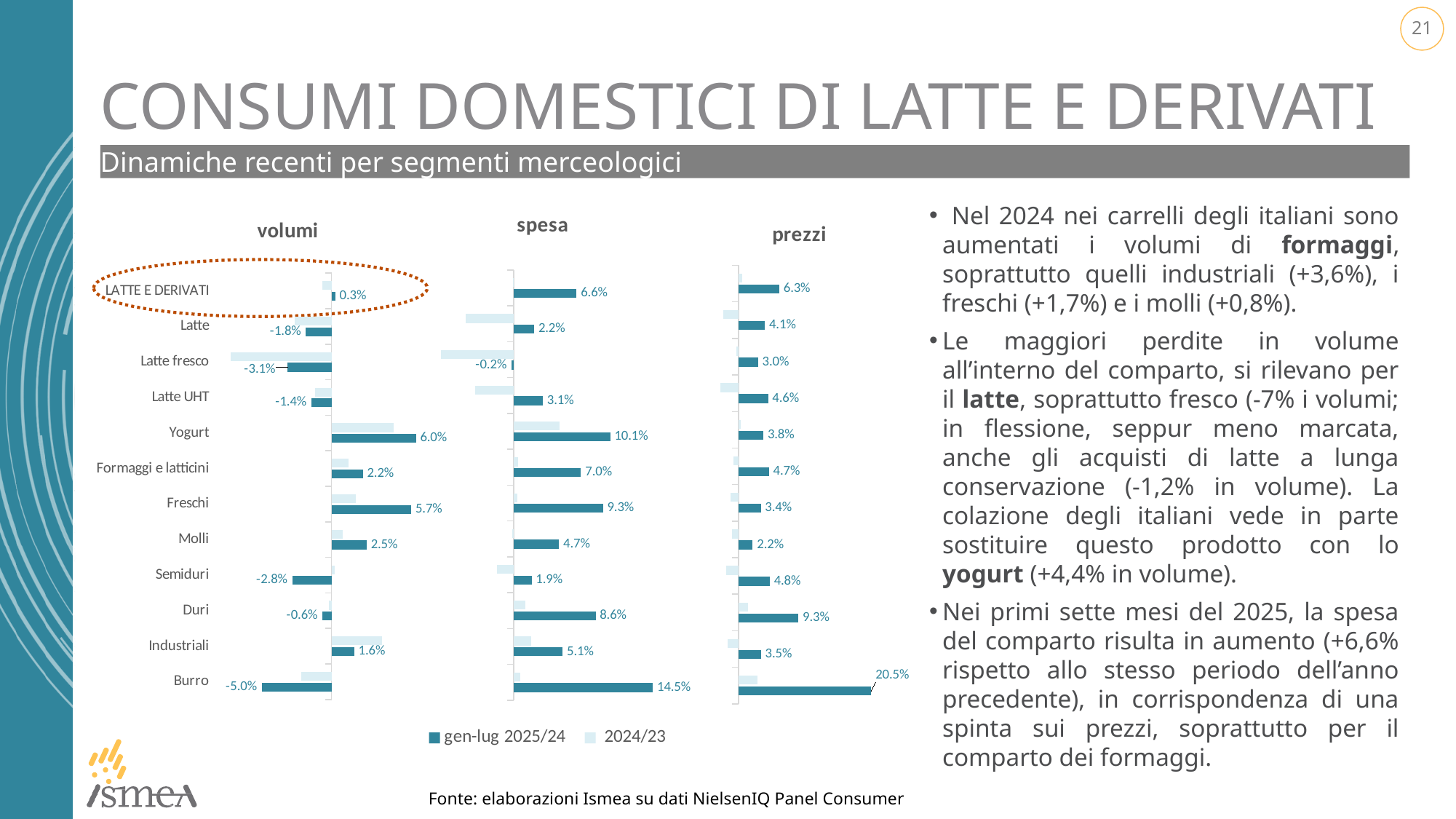
In the 'prezzi' chart, what is the gen-lug 2025/24 value for Duri? 9.3% In the 'spesa' chart, what is the gen-lug 2025/24 value for Burro? 14.5% How many series does the legend list for the charts? 2 In the 'spesa' chart, which category has the highest gen-lug 2025/24 value? Burro In the 'volumi' chart, which has a larger gen-lug 2025/24 value, Freschi or Molli? Freschi In the 'volumi' chart, what is the gen-lug 2025/24 value for Yogurt? 6.0% In the 'prezzi' chart, which has a larger gen-lug 2025/24 value, LATTE E DERIVATI or Latte? LATTE E DERIVATI In the 'spesa' chart, what is the difference between the gen-lug 2025/24 values for Yogurt and Freschi? 0.8% In the 'prezzi' chart, which category has the highest gen-lug 2025/24 value? Burro How many categories are shown in the 'volumi' chart? 12 In the 'volumi' chart, which category has the lowest gen-lug 2025/24 value? Burro What kind of chart is the 'spesa' chart? Bar chart